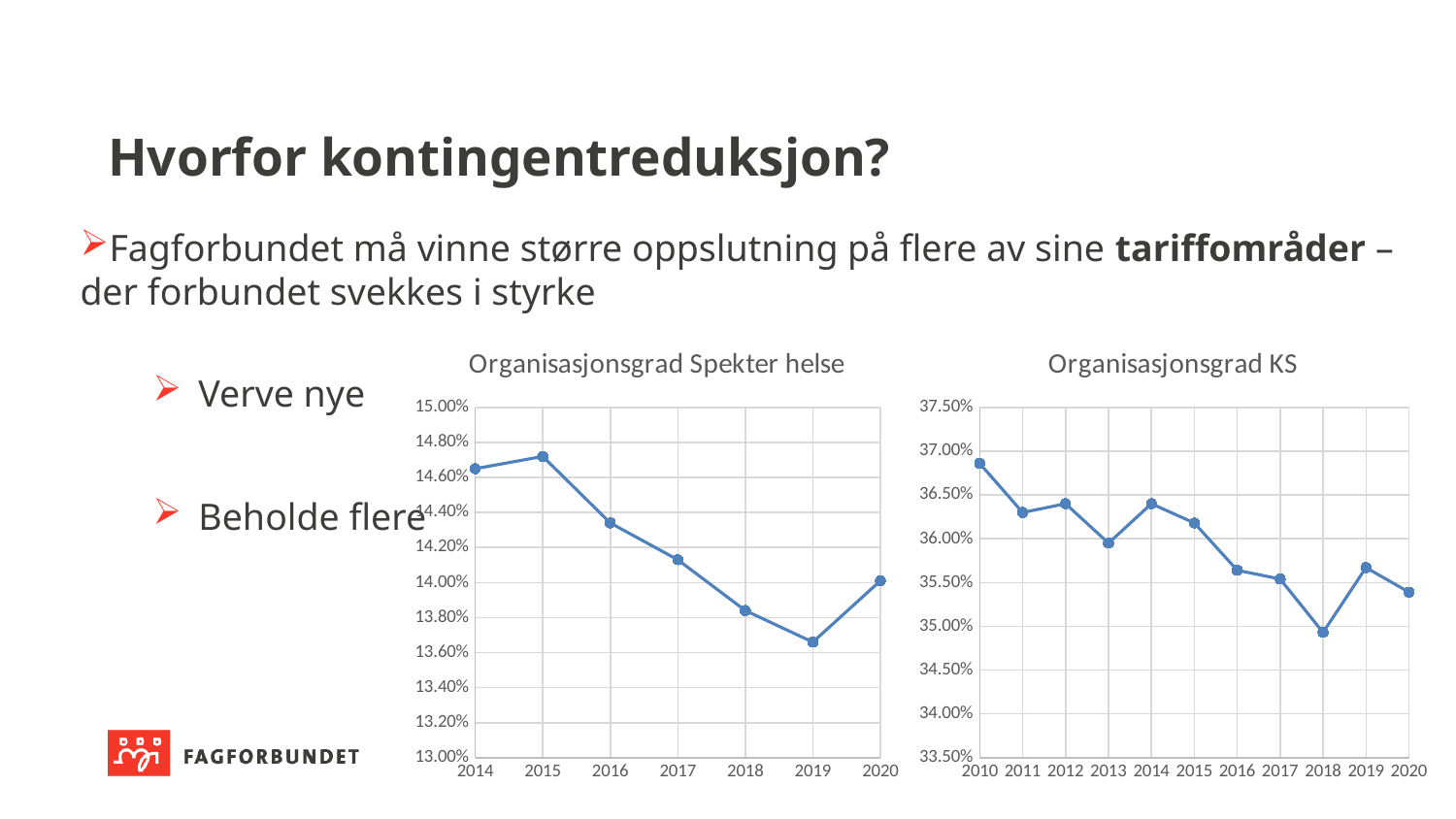
How many years are plotted in the "Organisasjonsgrad Spekter helse" chart? 7 In the "Organisasjonsgrad Spekter helse" chart, is the value for 2016 greater or less than 14.20%? greater In the "Organisasjonsgrad Spekter helse" chart, which is larger, the value for 2014 or the value for 2019? 2014 In the "Organisasjonsgrad Spekter helse" chart, which year has the lowest value? 2019 In the "Organisasjonsgrad KS" chart, do the values generally rise or fall from 2010 to 2020? fall In the "Organisasjonsgrad Spekter helse" chart, is the value for 2018 greater or less than 14.00%? less In the "Organisasjonsgrad KS" chart, which year has the highest value? 2010 How many years are plotted in the "Organisasjonsgrad KS" chart? 11 What type of chart is the "Organisasjonsgrad Spekter helse" chart? line chart In the "Organisasjonsgrad KS" chart, which year has the lowest value? 2018 In the "Organisasjonsgrad Spekter helse" chart, which year has the highest value? 2015